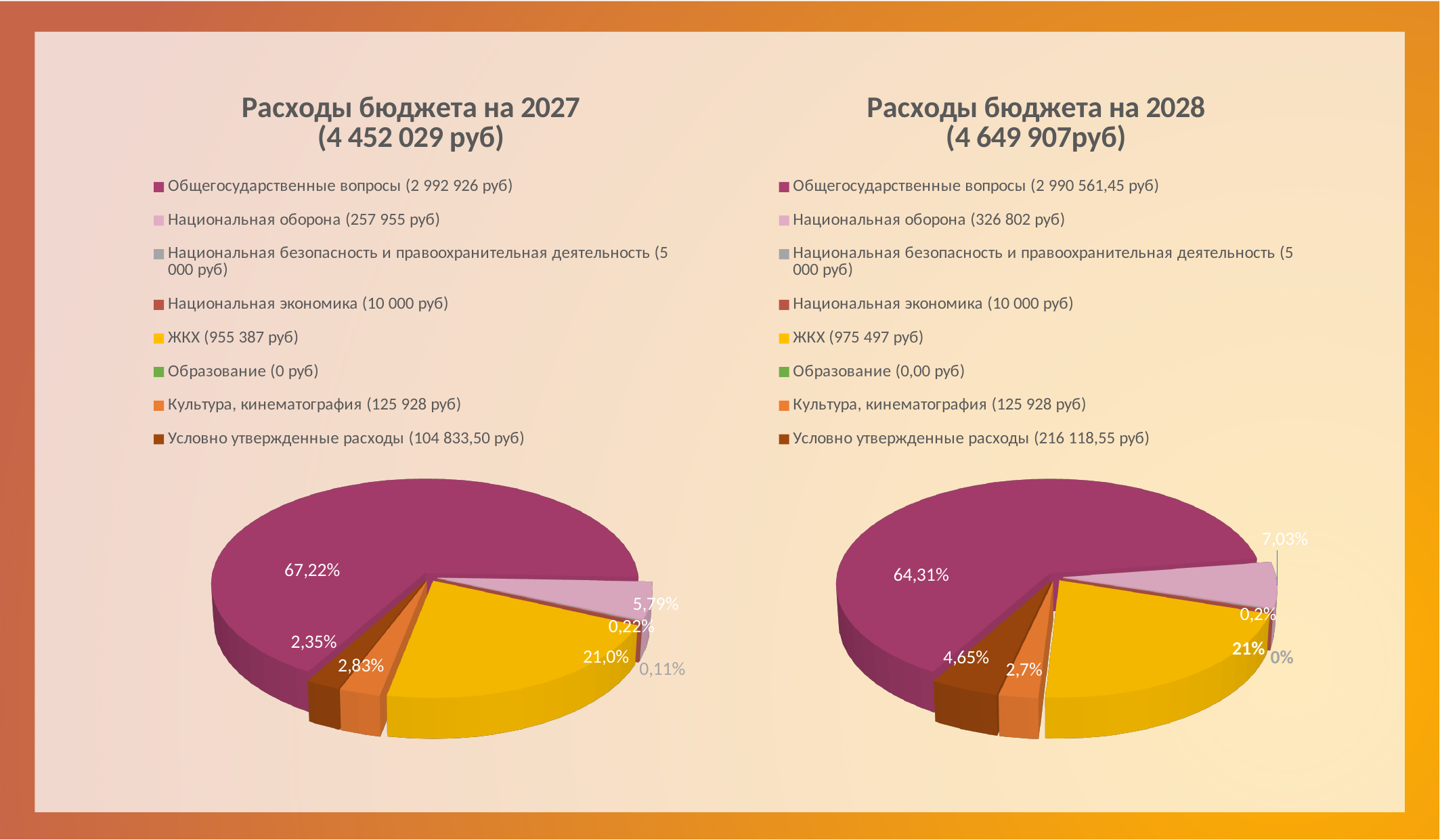
What is the total budget amount shown in the title of the left chart? 4 452 029 руб In the left chart 'Расходы бюджета на 2027', which category has the largest slice? Общегосударственные вопросы In the left chart 'Расходы бюджета на 2027', what is the share of the Культура, кинематография slice? 2,83% In the right chart 'Расходы бюджета на 2028', what is the share of the ЖКХ slice? 21% How many entries does the legend of the right chart 'Расходы бюджета на 2028' list? 8 In the left chart 'Расходы бюджета на 2027', what share does the largest slice have? 67,22% What kind of chart is the left chart, 'Расходы бюджета на 2027'? pie chart